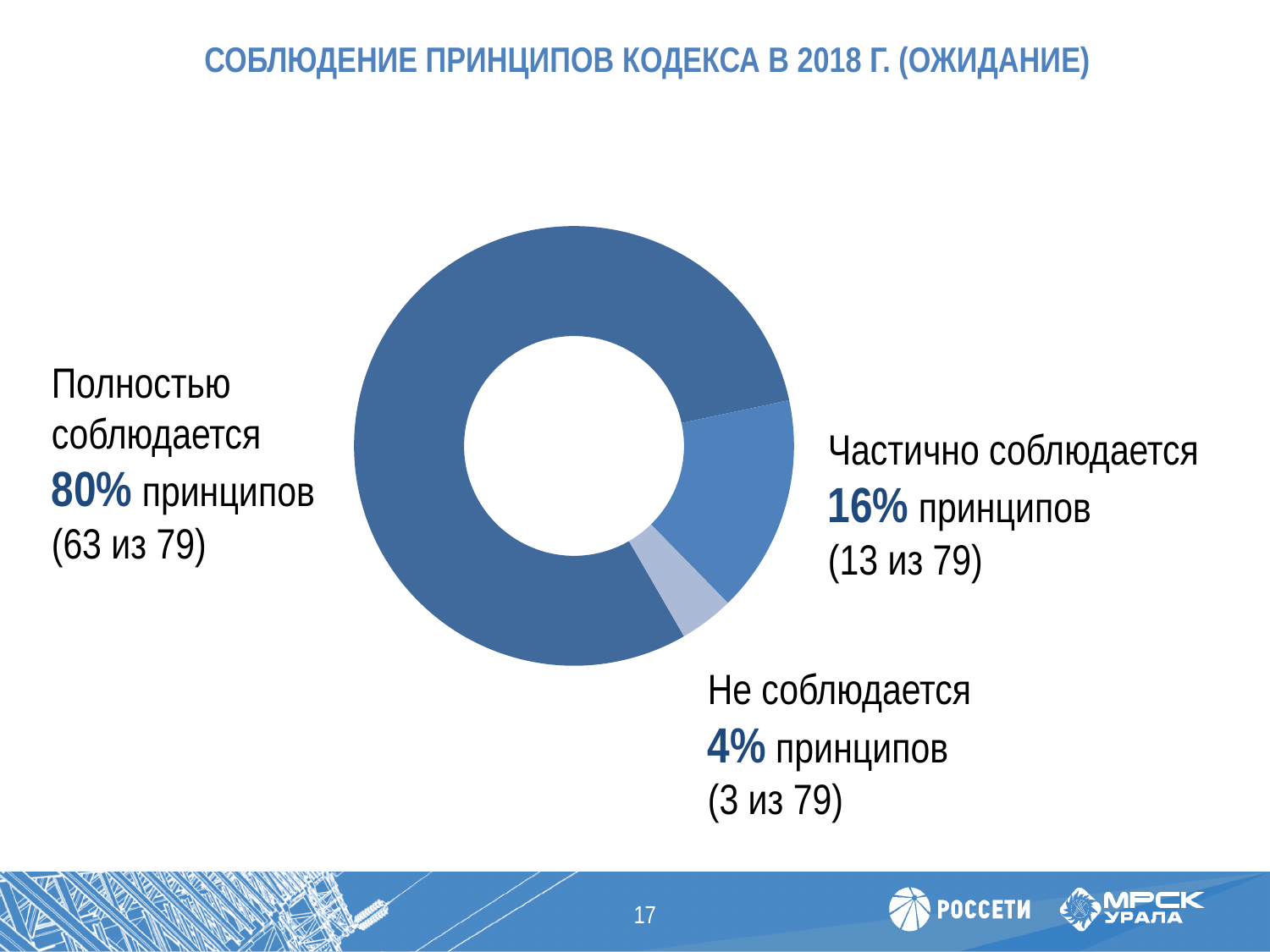
What is the difference in percentage points between the fully complied and partially complied shares? 64 Which category has the largest share of the chart? Полностью соблюдается What share of principles is partially complied with (Частично соблюдается)? 16% What share of principles is not complied with (Не соблюдается)? 4% How many principles are fully complied with, out of 79? 63 How many categories does the chart show? 3 How many principles are not complied with, out of 79? 3 What is the title of the slide? СОБЛЮДЕНИЕ ПРИНЦИПОВ КОДЕКСА В 2018 Г. (ОЖИДАНИЕ) What share of principles is fully complied with (Полностью соблюдается)? 80% How many principles are partially complied with, out of 79? 13 Which category has the smallest share of the chart? Не соблюдается What kind of chart is shown on the slide? Doughnut (pie) chart